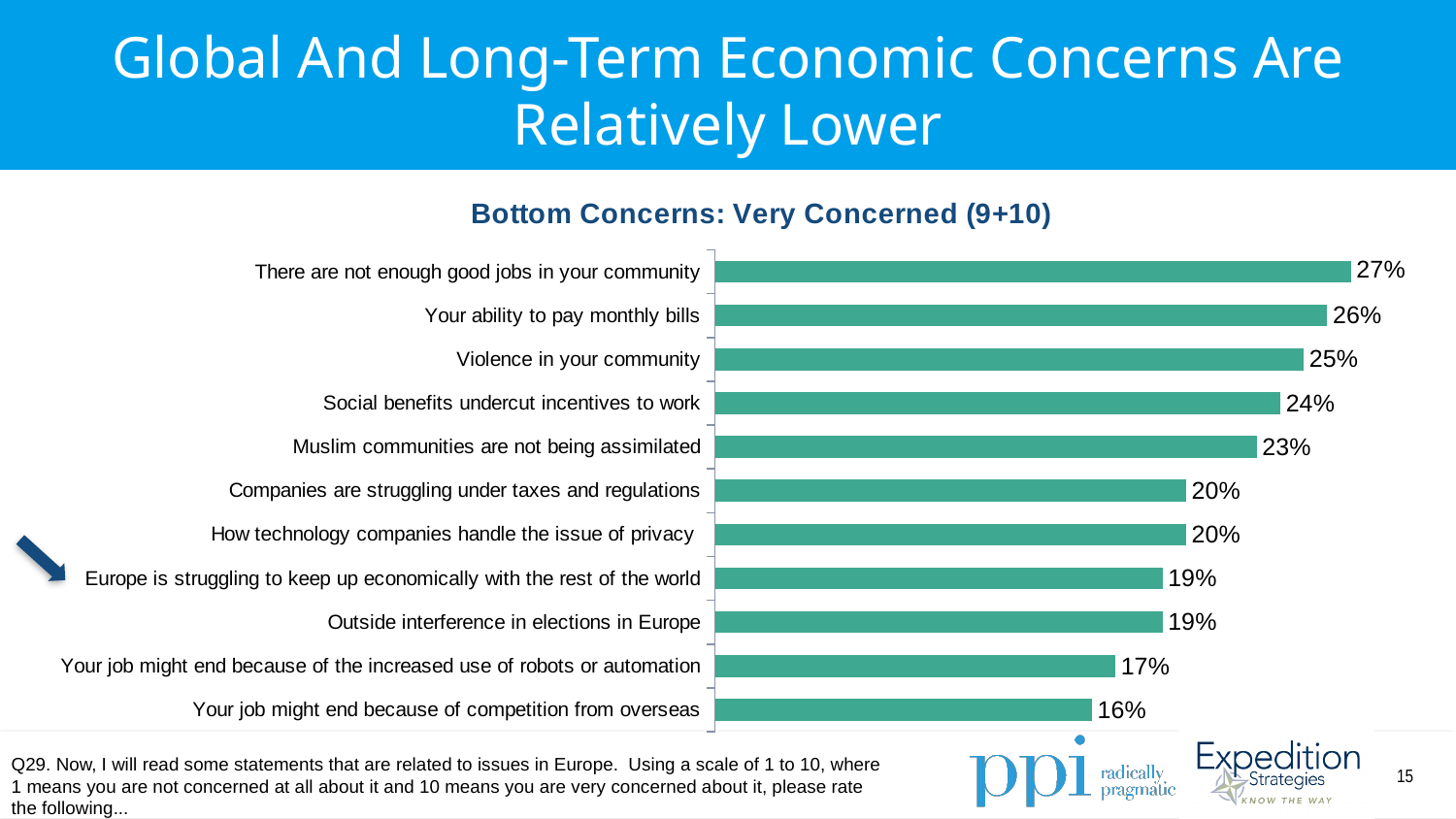
What percentage of respondents are very concerned that there are not enough good jobs in their community? 27% Which is larger: 'Violence in your community' or 'Social benefits undercut incentives to work'? Violence in your community Which concern has the lowest share of very concerned respondents? Your job might end because of competition from overseas What kind of chart is shown on the slide? Bar chart How many concerns are listed in the chart? 11 Which concern has the highest share of very concerned respondents? There are not enough good jobs in your community What is the value for 'Muslim communities are not being assimilated'? 23% What is the title of the chart? Bottom Concerns: Very Concerned (9+10) What is the difference between 'Your ability to pay monthly bills' and 'Outside interference in elections in Europe'? 7 percentage points What is the value for 'Your job might end because of the increased use of robots or automation'? 17% What is the difference between the highest and lowest values in the chart? 11 percentage points What is the value for 'Your job might end because of competition from overseas'? 16%